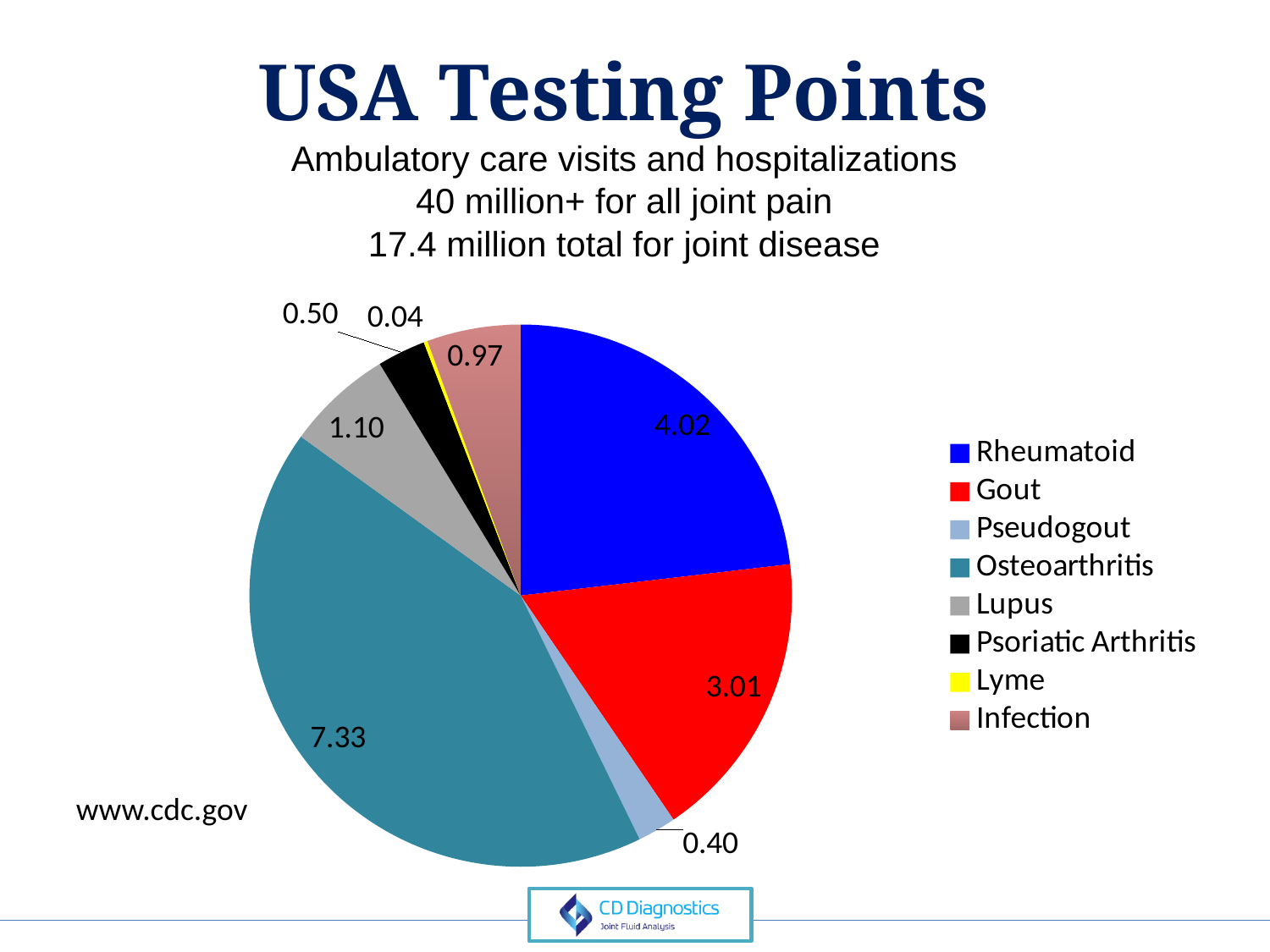
What is the difference between the values for Osteoarthritis and Rheumatoid? 3.31 What colour is the Gout slice in the pie chart? red Which category has the smallest slice of the pie chart? Lyme What is the value for Pseudogout in the pie chart? 0.40 Which is larger, the value for Lupus or the value for Infection? Lupus What type of chart is shown on the slide? pie chart How many categories does the pie chart have? 8 What is the value for Osteoarthritis in the pie chart? 7.33 What is the value for Lyme in the pie chart? 0.04 Which category has the largest slice of the pie chart? Osteoarthritis What is the difference between the values for Rheumatoid and Gout? 1.01 What is the value for Rheumatoid in the pie chart? 4.02